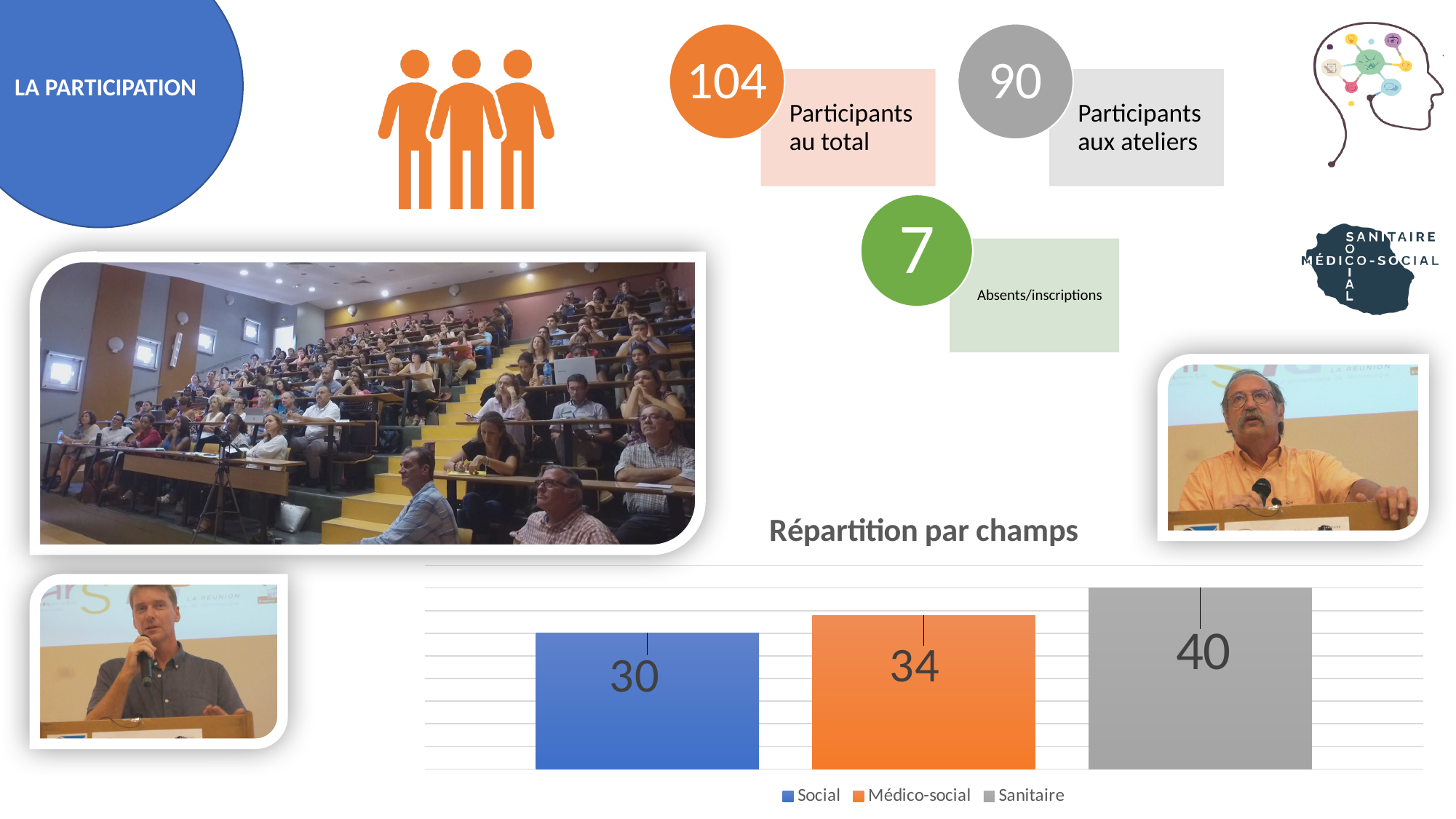
Which category has the highest value in the 'Répartition par champs' chart? Sanitaire What is the value for Sanitaire in the 'Répartition par champs' chart? 40 What is the difference between the Médico-social and Social values in the 'Répartition par champs' chart? 4 How many categories are shown in the 'Répartition par champs' chart? 3 Which category has the lowest value in the 'Répartition par champs' chart? Social What is the value for Social in the 'Répartition par champs' chart? 30 Which is larger in the 'Répartition par champs' chart, Médico-social or Sanitaire? Sanitaire What kind of chart is 'Répartition par champs'? Bar chart What colour is the Médico-social bar in the 'Répartition par champs' chart? Orange What is the value for Médico-social in the 'Répartition par champs' chart? 34 What is the difference between the Sanitaire and Social values in the 'Répartition par champs' chart? 10 How many entries does the legend of the 'Répartition par champs' chart list? 3